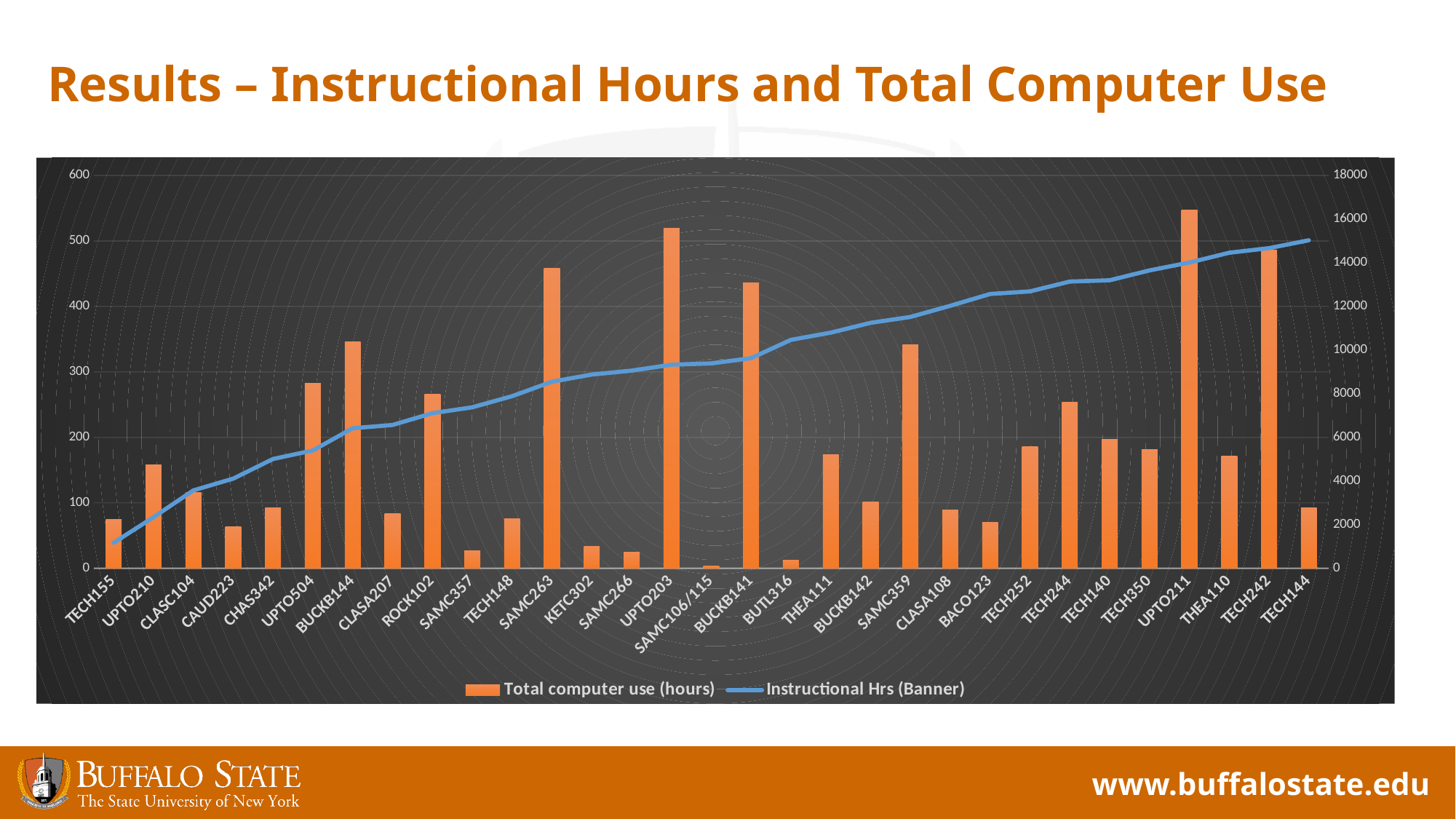
What kind of chart is shown on the slide? bar chart with a line How many rooms (categories) are shown along the x axis? 31 How many series does the legend list? 2 Which has the larger total computer use, UPTO203 or BUCKB141? UPTO203 Is the total computer use for SAMC263 greater or less than 400 hours? greater What are the two series named in the legend? Total computer use (hours) and Instructional Hrs (Banner) Does the Instructional Hrs (Banner) line rise or fall from left to right across the rooms? rise Which room has the lowest total computer use (hours)? SAMC106/115 Which has the larger total computer use, THEA111 or BUCKB142? THEA111 Is the total computer use for UPTO504 greater or less than 200 hours? greater Which room has the highest total computer use (hours)? UPTO211